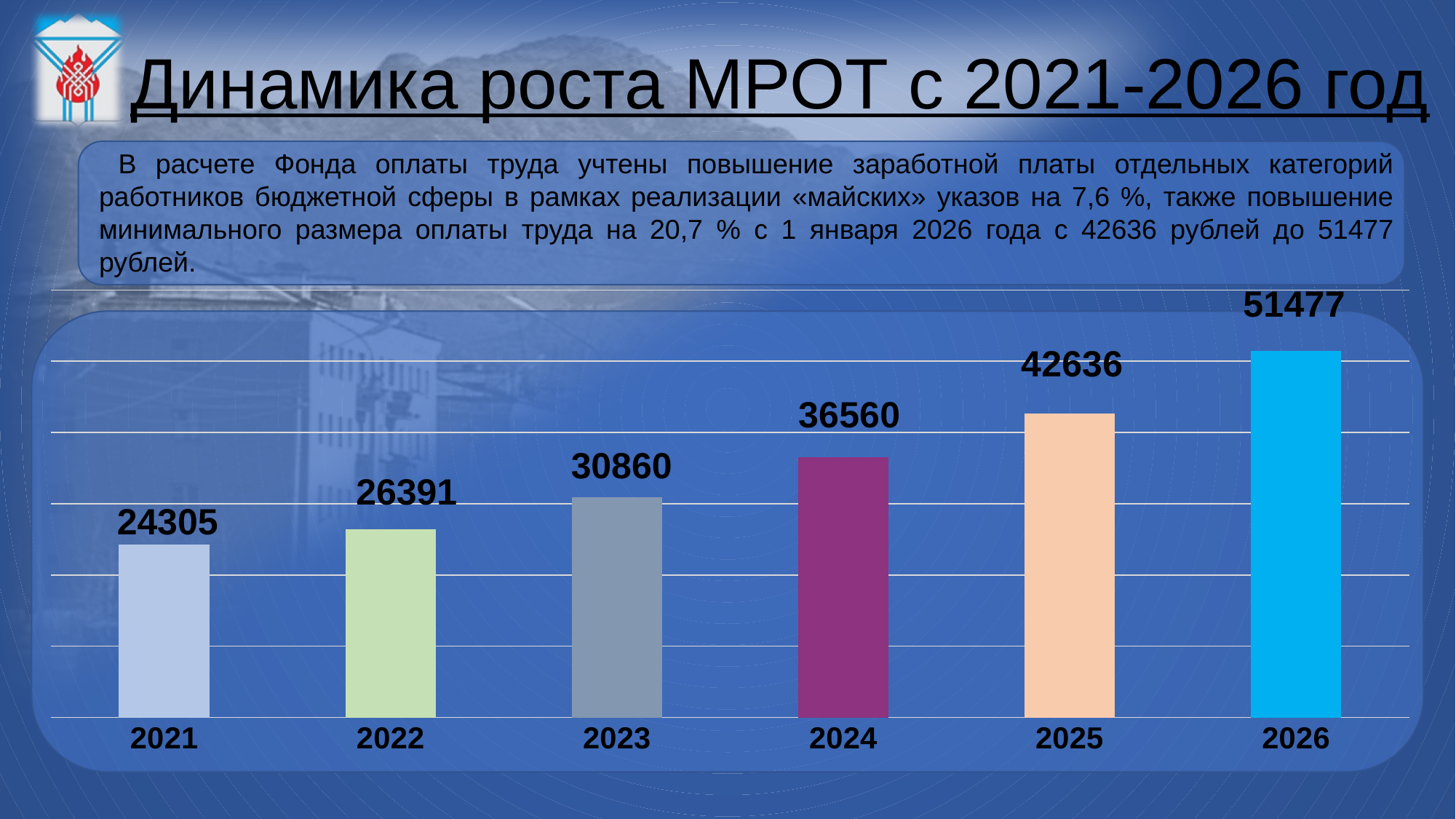
Which is larger, the value for 2023 or the value for 2024? 2024 What is the value shown for 2024? 36560 What is the difference between the values for 2022 and 2021? 2086 What is the title of the slide containing the chart? Динамика роста МРОТ с 2021-2026 год What kind of chart is shown on the slide? bar chart What is the value shown for 2026? 51477 What is the value shown for 2021? 24305 How many years are shown on the chart? 6 Which year has the lowest value? 2021 Which year has the highest value? 2026 What is the difference between the values for 2026 and 2025? 8841 Do the values rise or fall from 2021 to 2026? rise